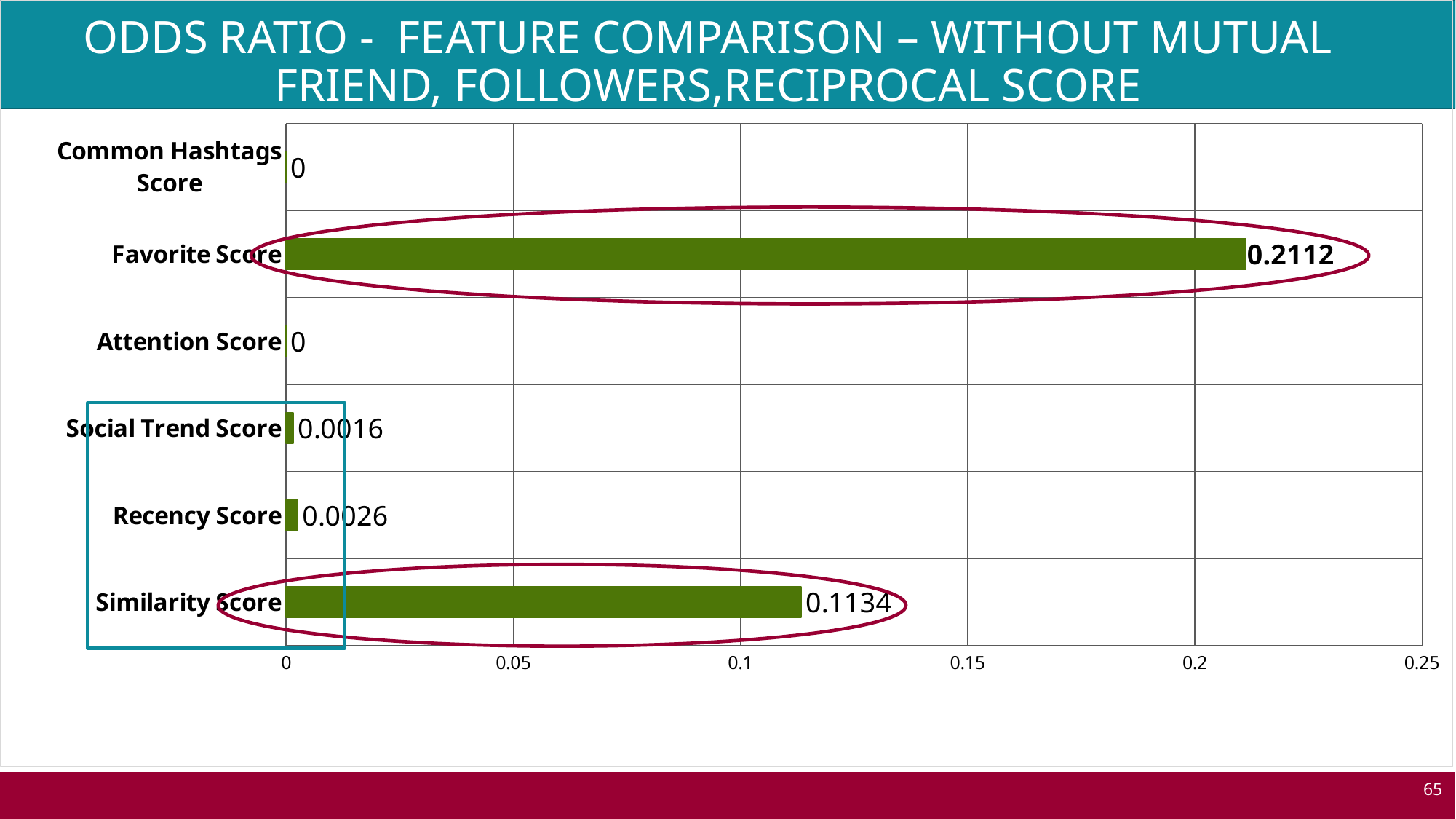
What is the maximum value shown on the horizontal axis? 0.25 What is the value for Attention Score? 0 Is the value for Favorite Score greater or less than 0.2? greater Which category has the highest value? Favorite Score What is the value for Social Trend Score? 0.0016 What is the value for Recency Score? 0.0026 What kind of chart is shown on the slide? bar chart What is the value for Similarity Score? 0.1134 Which is larger, the value for Recency Score or the value for Social Trend Score? Recency Score How many categories are shown in the chart? 6 What is the difference between the values for Favorite Score and Similarity Score? 0.0978 What is the value for Favorite Score? 0.2112